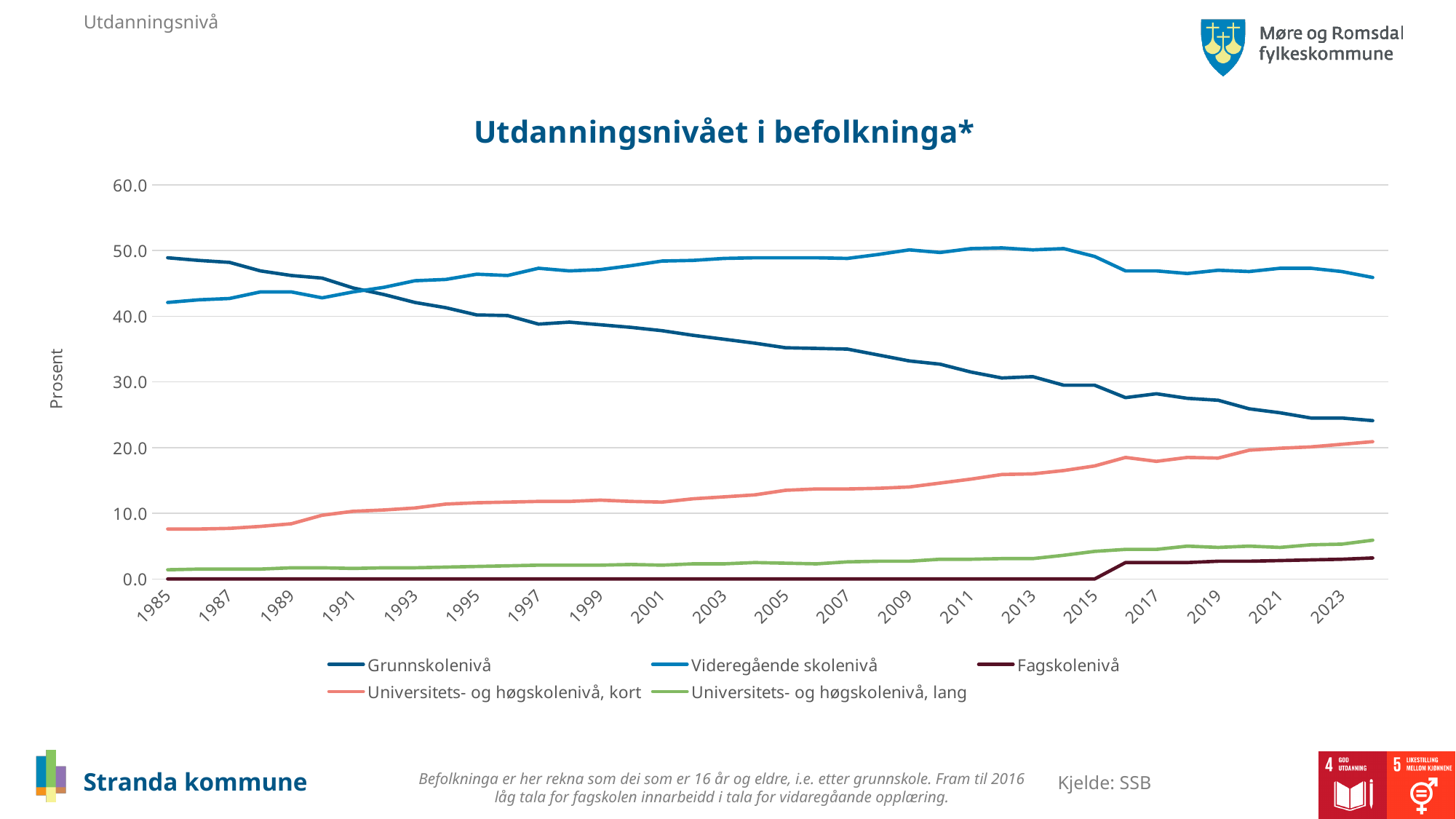
Is the value for Videregående skolenivå in 2023 greater or less than 40.0? greater What is the value for Fagskolenivå in 1995? 0.0 Which series has the lowest value in 2023? Fagskolenivå What is the label on the y axis? Prosent Does the value for Grunnskolenivå rise or fall from 1985 to 2023? fall How many series does the legend list? 5 What kind of chart is shown on the slide? line chart Is the value for Grunnskolenivå in 2023 greater or less than 30.0? less In 1985, which is larger: Grunnskolenivå or Videregående skolenivå? Grunnskolenivå What is the title of the chart? Utdanningsnivået i befolkninga* Does the value for Universitets- og høgskolenivå, kort rise or fall from 1985 to 2023? rise Which series has the highest value in 2023? Videregående skolenivå